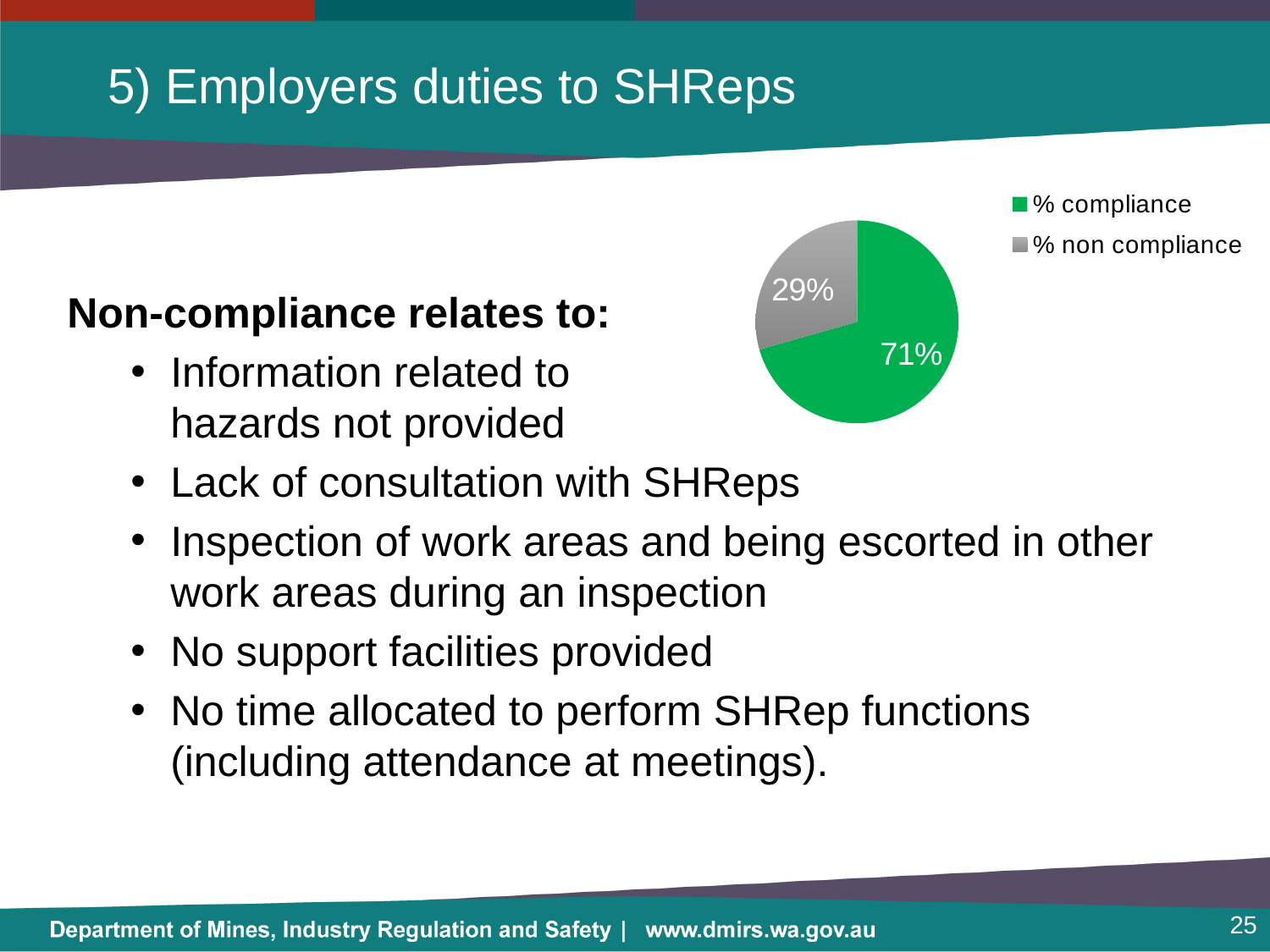
What colour is the % non compliance slice in the pie chart? Grey What kind of chart is shown on the slide? Pie chart Which slice of the pie chart is the smallest? % non compliance Which slice of the pie chart is the largest? % compliance How many entries does the legend of the pie chart list? 2 What percentage of the pie chart is labelled "% compliance"? 71% What percentage of the pie chart is labelled "% non compliance"? 29% What is the difference in percentage points between the % compliance slice and the % non compliance slice? 42 Which is larger in the pie chart, % compliance or % non compliance? % compliance What colour is the % compliance slice in the pie chart? Green How many slices does the pie chart have? 2 What share of the pie does the % non compliance slice represent? 29%